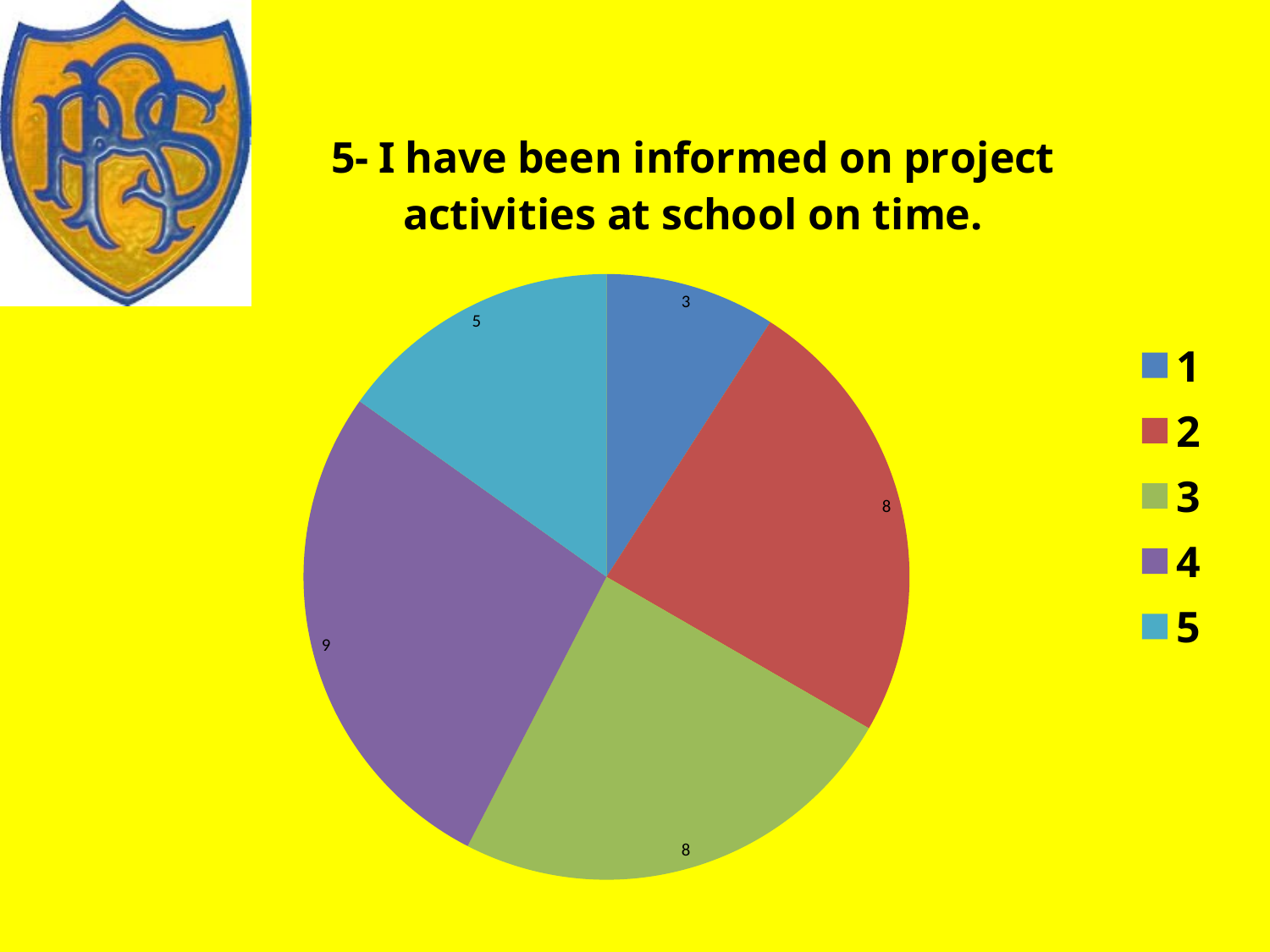
What type of chart is shown on the slide? pie chart Which is larger, the value for category 4 or the value for category 5? 4 How many categories does the legend list? 5 What is the value for category 1? 3 What is the difference between the values for category 4 and category 1? 6 Which category has the largest slice of the pie? 4 What is the difference between the values for category 2 and category 5? 3 What is the title of the chart? 5- I have been informed on project activities at school on time. Which category has the smallest slice of the pie? 1 What is the value for category 2? 8 What is the value for category 4? 9 What is the value for category 5? 5